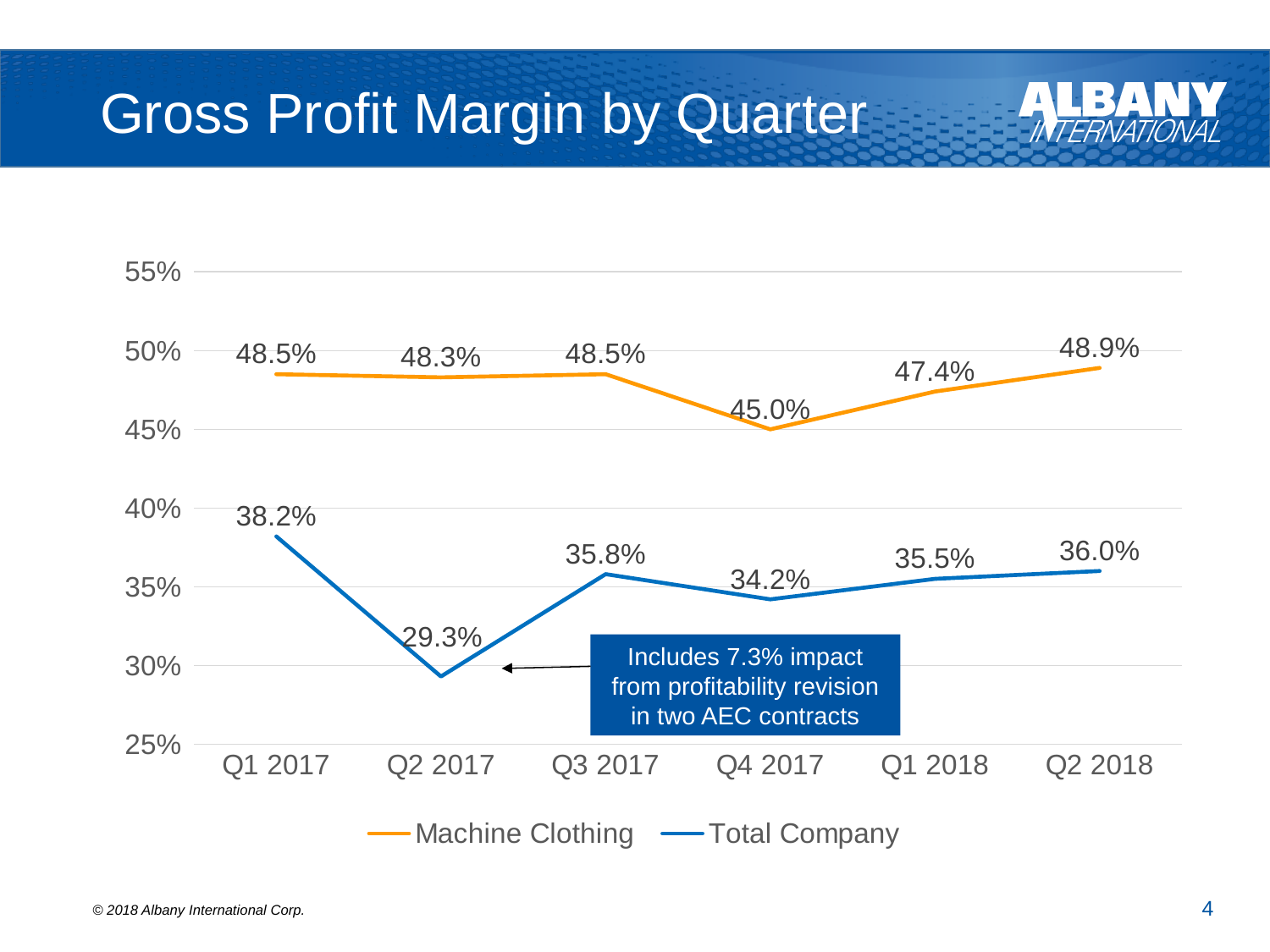
In which quarter is the Total Company gross profit margin lowest? Q2 2017 Which colour is used for the Machine Clothing line? orange Is the Total Company value for Q2 2017 greater or less than 30%? less What is the difference between the Machine Clothing and Total Company margins in Q1 2017? 10.3% How many series does the legend list? 2 What is the Machine Clothing gross profit margin in Q4 2017? 45.0% What is the Total Company gross profit margin in Q2 2017? 29.3% In which quarter is the Machine Clothing gross profit margin highest? Q2 2018 What is the Total Company value for Q2 2018? 36.0% Which is larger, the Total Company margin in Q1 2017 or in Q2 2018? Q1 2017 How many quarters are shown on the x axis? 6 What kind of chart is shown on the slide? line chart